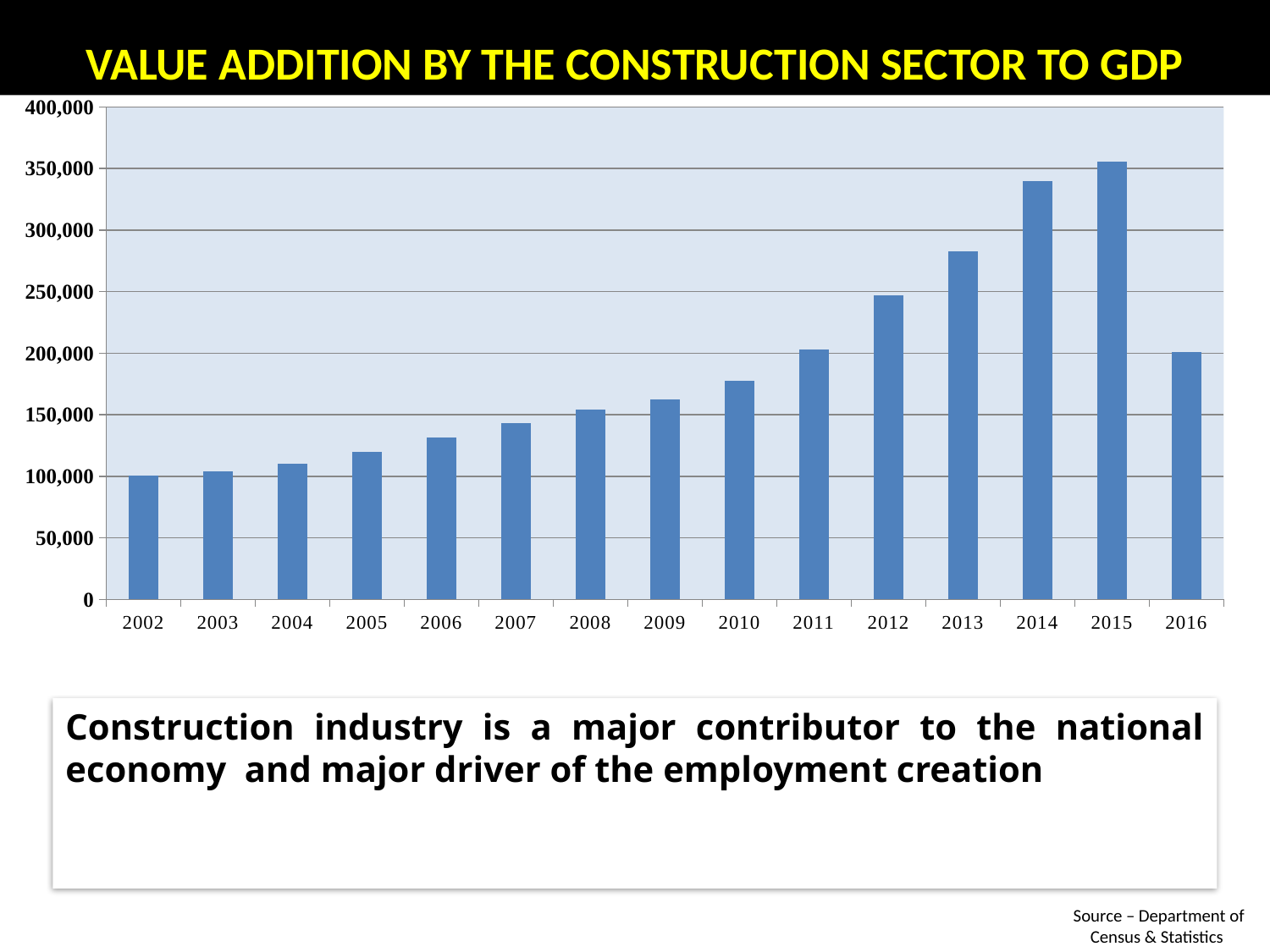
Do the values rise or fall from 2002 to 2015? rise Which year has the highest value addition by the construction sector to GDP? 2015 Which year has the lowest value addition by the construction sector to GDP? 2002 How many years are plotted on the chart? 15 Which year has the larger value, 2011 or 2012? 2012 What is the title of the chart on the slide? VALUE ADDITION BY THE CONSTRUCTION SECTOR TO GDP Is the value for 2013 greater or less than 250,000? greater What kind of chart is shown on the slide? bar chart Is the value for 2014 greater or less than 300,000? greater Is the value for 2016 greater or less than 250,000? less Which year has the larger value, 2014 or 2016? 2014